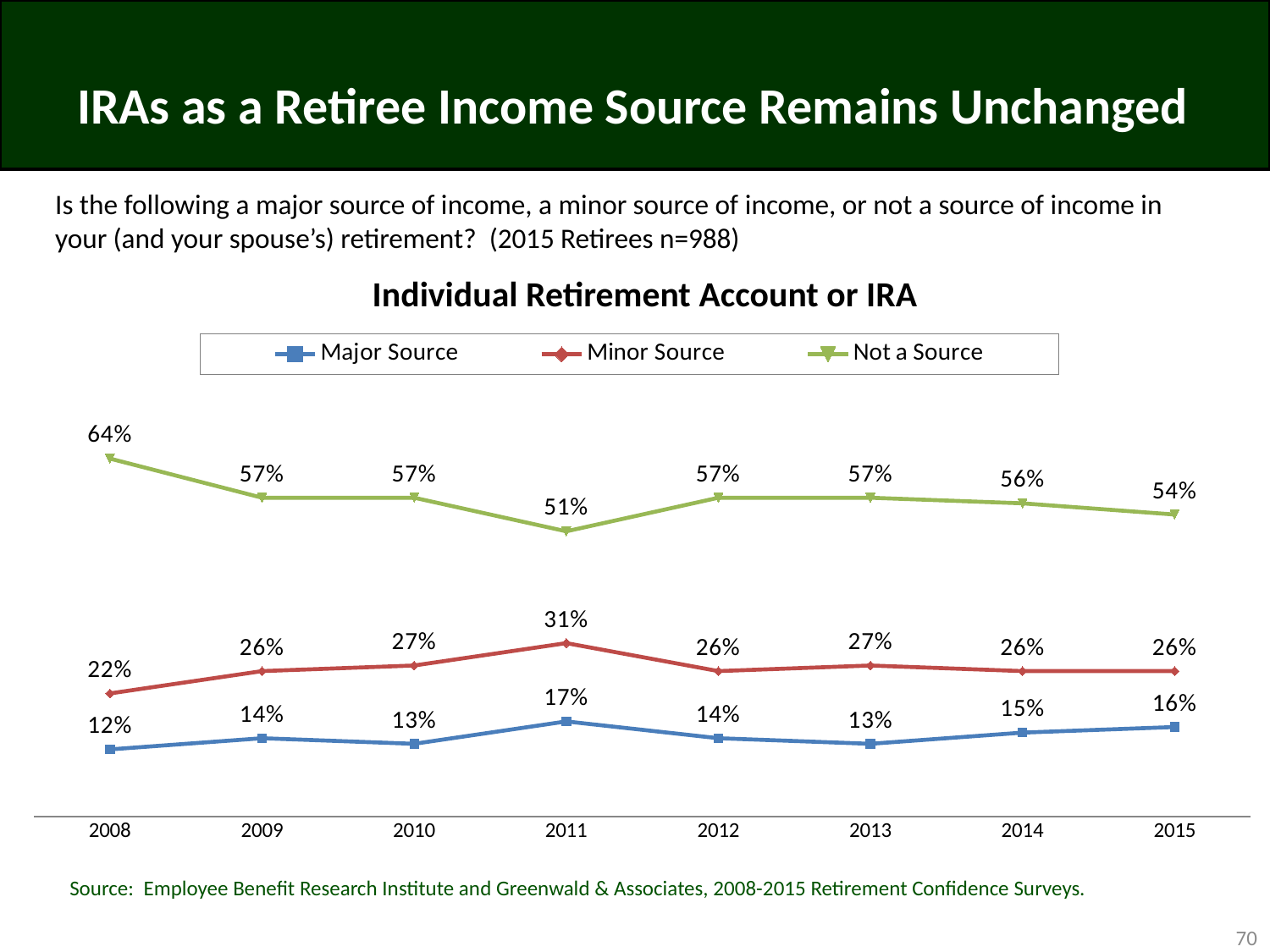
What percentage of retirees said an IRA was not a source of income in 2008? 64% How many years are shown on the x axis? 8 Did the Not a Source value rise or fall from 2008 to 2011? Fall What was the Minor Source value in 2011? 31% What kind of chart is shown on the slide? Line chart In which year was the Major Source value highest? 2011 What percentage of retirees said an IRA was a major source of income in 2015? 16% What is the difference between the Not a Source values in 2008 and 2015? 10 percentage points In which year was the Not a Source value lowest? 2011 Which is larger in 2013: the Minor Source value or the Major Source value? Minor Source How many series does the legend list? 3 What is the title of the chart? Individual Retirement Account or IRA